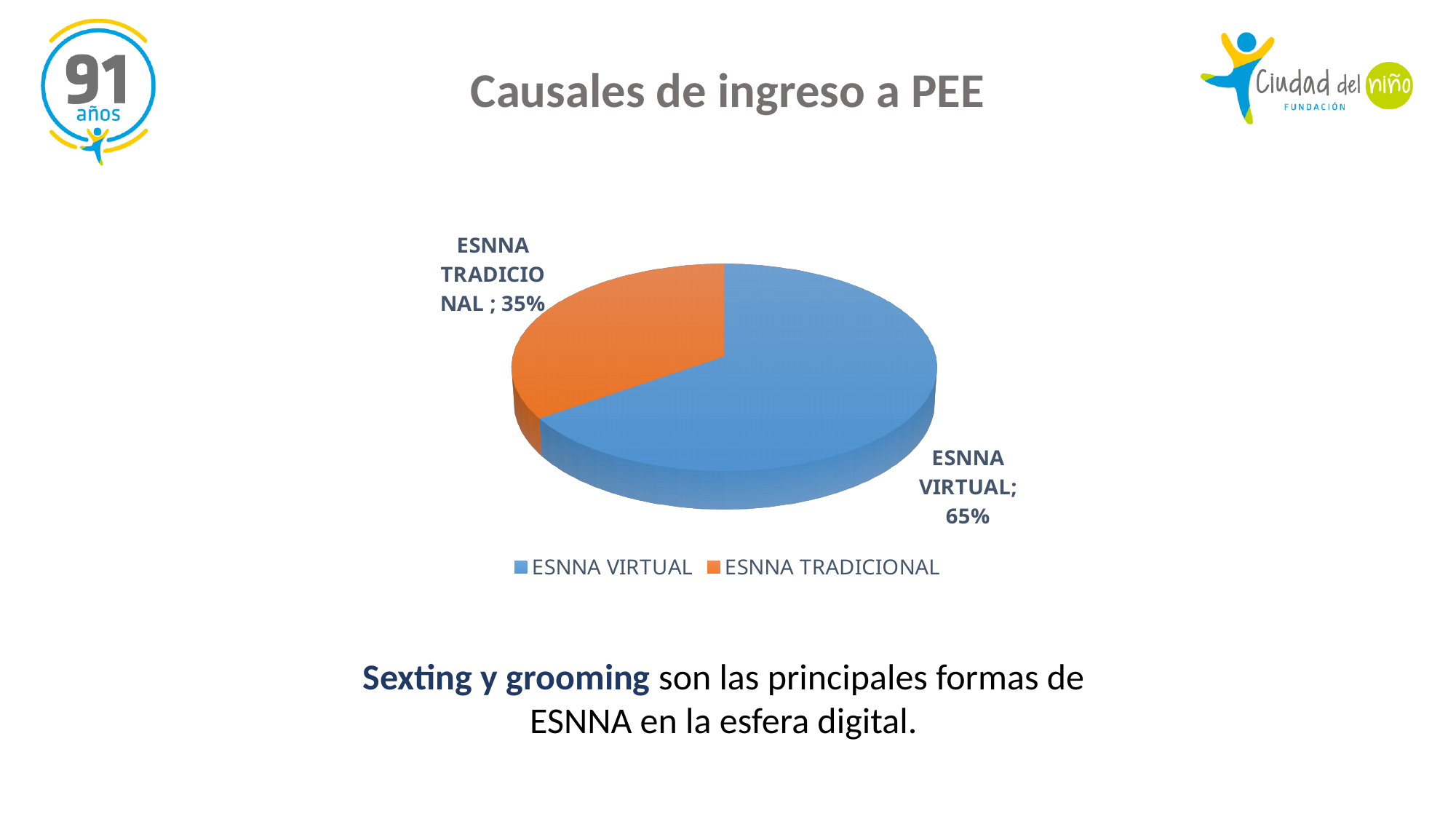
What share of the pie does ESNNA TRADICIONAL represent? 35% How many entries does the legend list? 2 What colour is the ESNNA TRADICIONAL slice? Orange Which is larger, ESNNA VIRTUAL or ESNNA TRADICIONAL? ESNNA VIRTUAL What is the difference in percentage points between ESNNA VIRTUAL and ESNNA TRADICIONAL? 30 What share of the pie does ESNNA VIRTUAL represent? 65% What kind of chart is shown on the slide? Pie chart Which category has the largest slice of the pie? ESNNA VIRTUAL What is the title of the chart on the slide? Causales de ingreso a PEE How many slices does the pie chart have? 2 Which category has the smallest slice of the pie? ESNNA TRADICIONAL